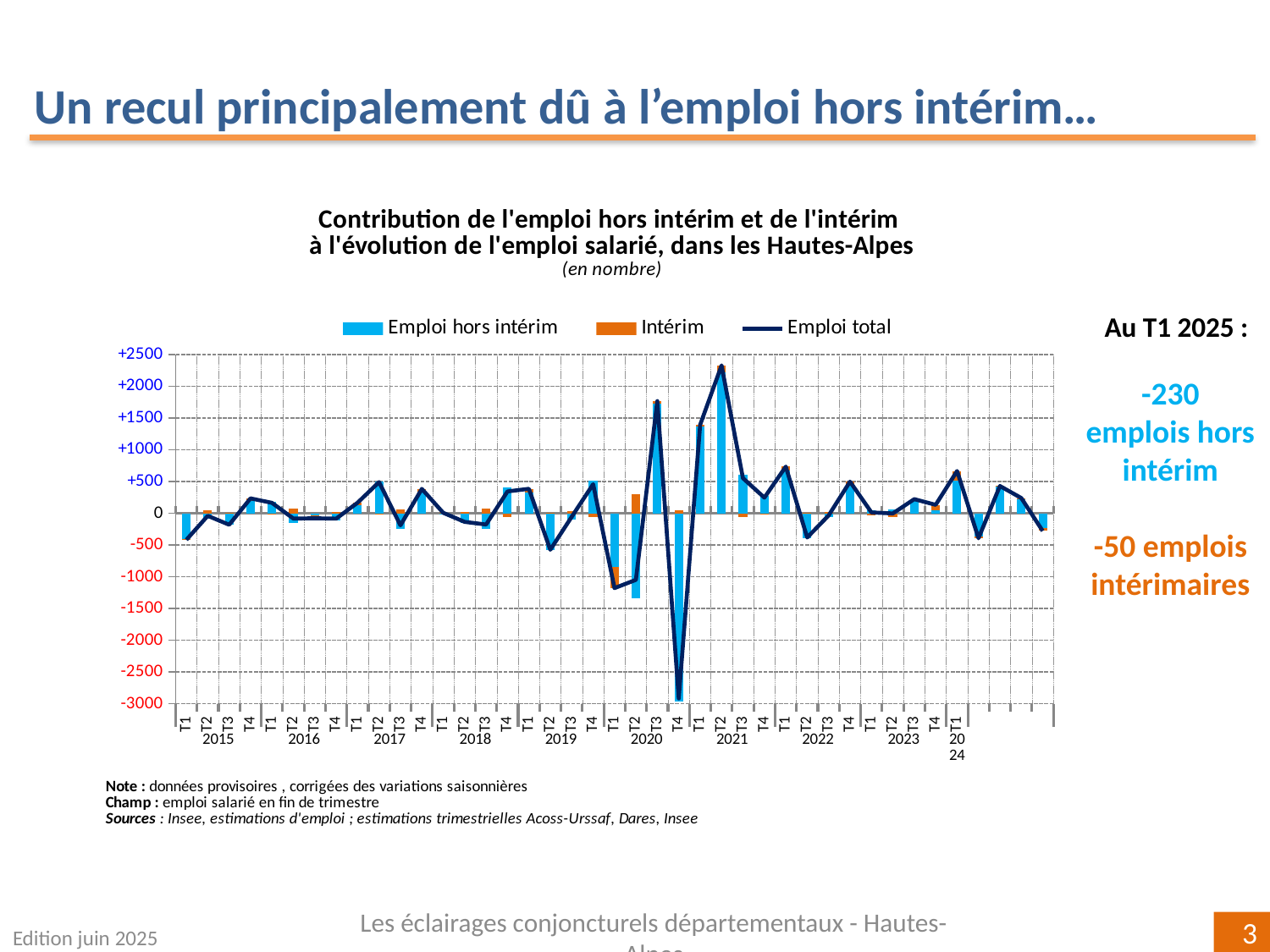
Is the value of Emploi total at T4 2020 greater or less than -2500? less How many series does the chart legend list? 3 Which is larger: the Emploi hors intérim bar at T2 2021 or at T3 2020? T2 2021 In which quarter does the Emploi total line reach its highest point? T2 2021 According to the slide, what is the contribution of emploi hors intérim at T1 2025? -230 In which quarter does the Emploi total line reach its lowest point? T4 2020 Adding the two contributions given for T1 2025 (-230 emplois hors intérim and -50 emplois intérimaires), what is the total change in employment? -280 Is the value of Emploi hors intérim at T2 2020 greater or less than -1000? less Is the value of Emploi total at T2 2021 greater or less than 2000? greater What kind of chart is shown on the slide? A combined bar and line chart According to the slide, what is the contribution of emplois intérimaires at T1 2025? -50 What are the three series named in the chart legend? Emploi hors intérim, Intérim, Emploi total